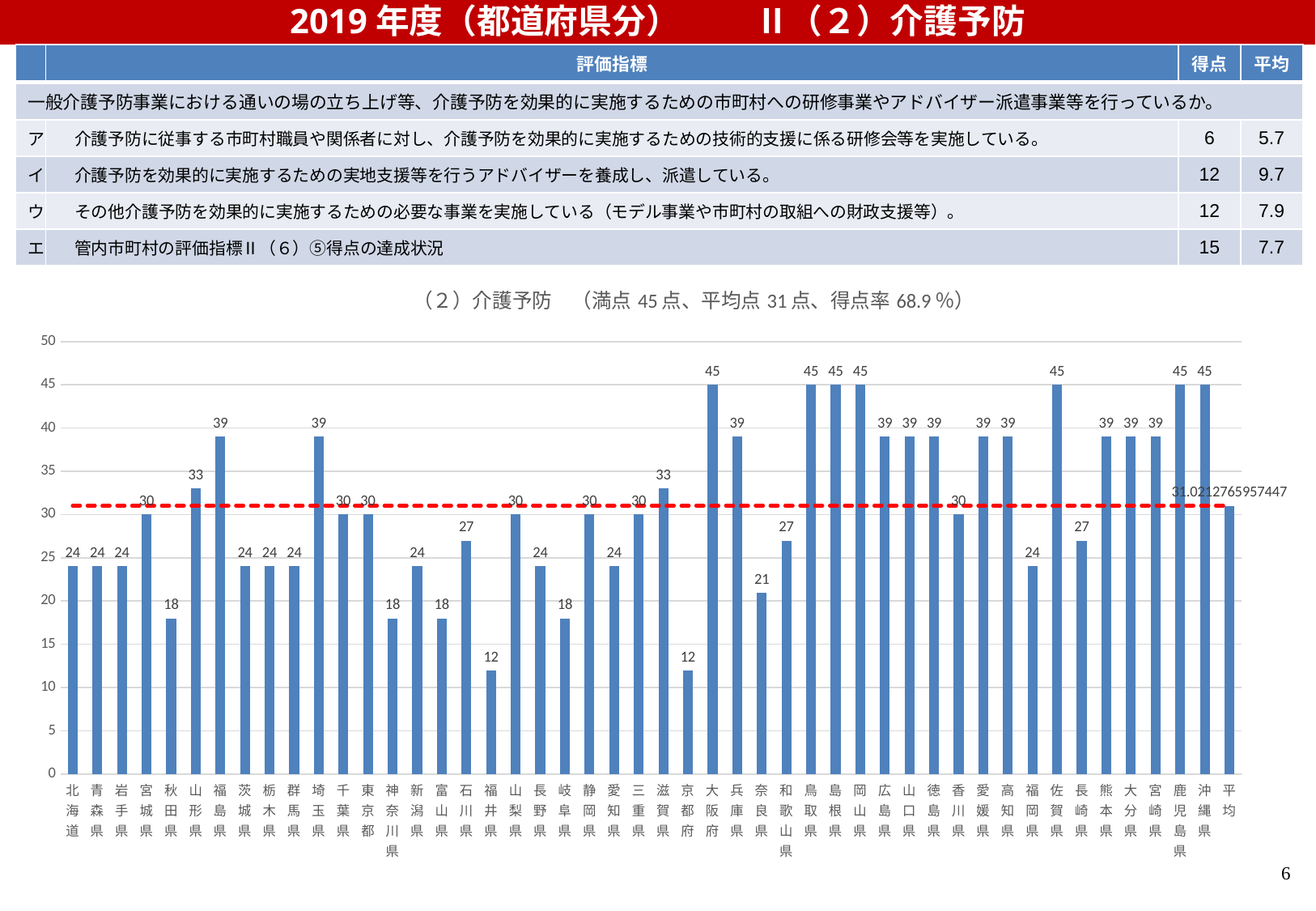
What kind of chart is shown on the slide? combination bar and line chart (bars with a dashed average line) What is the lowest value plotted in the chart? 12 What is the title of the chart? （２）介護予防 （満点 45 点、平均点 31 点、得点率 68.9％） What is the value for 奈良県? 21 What is the value for 滋賀県? 33 What is the highest value plotted in the chart? 45 What is the difference between the values for 福島県 and 福井県? 27 Which has a larger value, 山形県 or 秋田県? 山形県 What is the value shown for 平均 (the average bar)? 31 Which has a larger value, 京都府 or 兵庫県? 兵庫県 What is the value for 秋田県? 18 What is the difference between the values for 大阪府 and 奈良県? 24